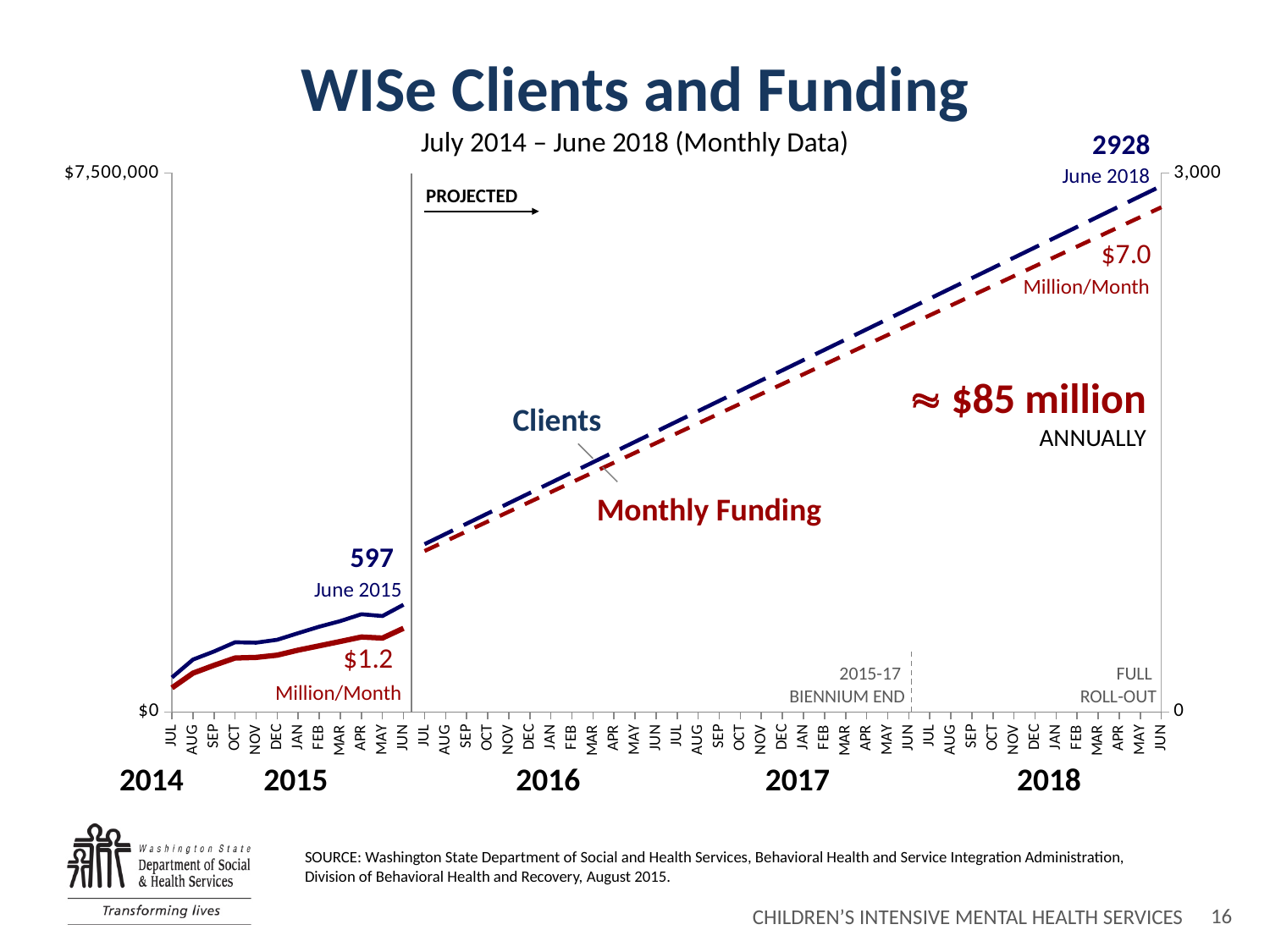
Is the projected number of clients in June 2018 greater or less than 3,000? less How many data series are plotted on the chart? 2 How many WISe clients are projected for June 2018? 2928 What kind of chart is shown on the slide? line chart What annual funding figure is annotated on the chart? ≈ $85 million Do the client numbers rise or fall from July 2014 to June 2018? rise What was the monthly funding in June 2015? $1.2 Million/Month Which is larger, the number of clients in June 2015 or in June 2018? June 2018 How many WISe clients were there in June 2015? 597 By how many clients does the June 2018 projection exceed the June 2015 figure? 2331 What is the projected monthly funding for June 2018? $7.0 Million/Month What is the title of the chart? WISe Clients and Funding